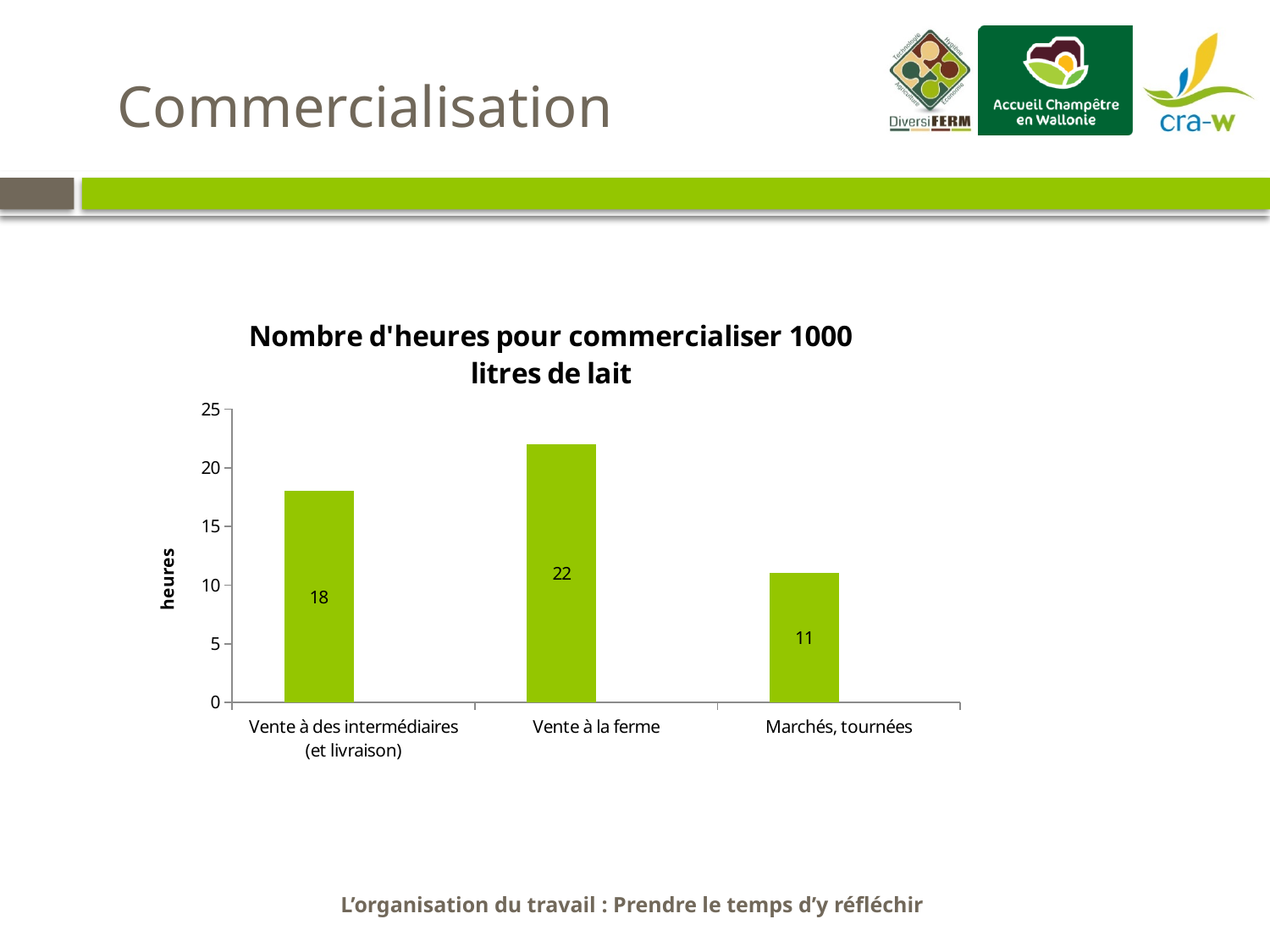
What is the title of the chart? Nombre d'heures pour commercialiser 1000 litres de lait What is the value for Vente à la ferme? 22 What is the difference between the values for Vente à la ferme and Vente à des intermédiaires (et livraison)? 4 What is the value for Vente à des intermédiaires (et livraison)? 18 Is the value for Vente à la ferme greater or less than 20? greater Which category has the lowest value? Marchés, tournées Which category has the highest value? Vente à la ferme What kind of chart is shown on the slide? bar chart What is the difference between the values for Vente à la ferme and Marchés, tournées? 11 How many categories are shown in the chart? 3 What is the value for Marchés, tournées? 11 Which is larger, the value for Vente à des intermédiaires (et livraison) or the value for Marchés, tournées? Vente à des intermédiaires (et livraison)